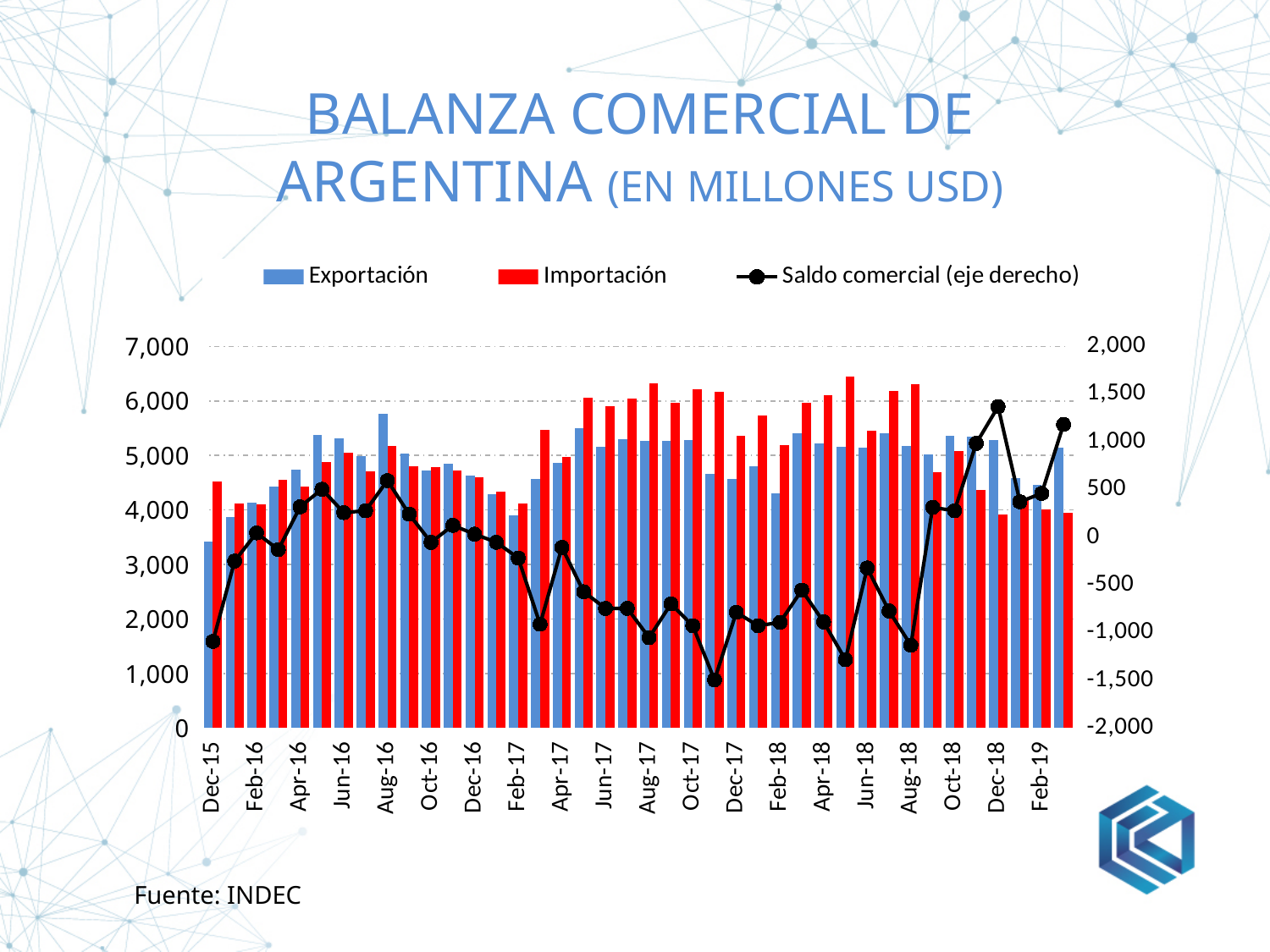
What kind of chart is shown on the slide? A combined bar and line chart How many series does the legend list? 3 Is the Saldo comercial value for Dec-18 greater or less than 1,000? greater Does the Saldo comercial rise or fall between Aug-18 and Dec-18? rise In which month is the Saldo comercial at its lowest? Nov-17 Is the Exportación value for Dec-15 greater or less than 4,000? less Is the Saldo comercial value for Dec-17 greater or less than -1,000? greater In Dec-15, which is larger, Exportación or Importación? Importación What is the source cited for the chart? INDEC In which month does Exportación reach its highest value? Aug-16 Which series is plotted on the right-hand axis? Saldo comercial